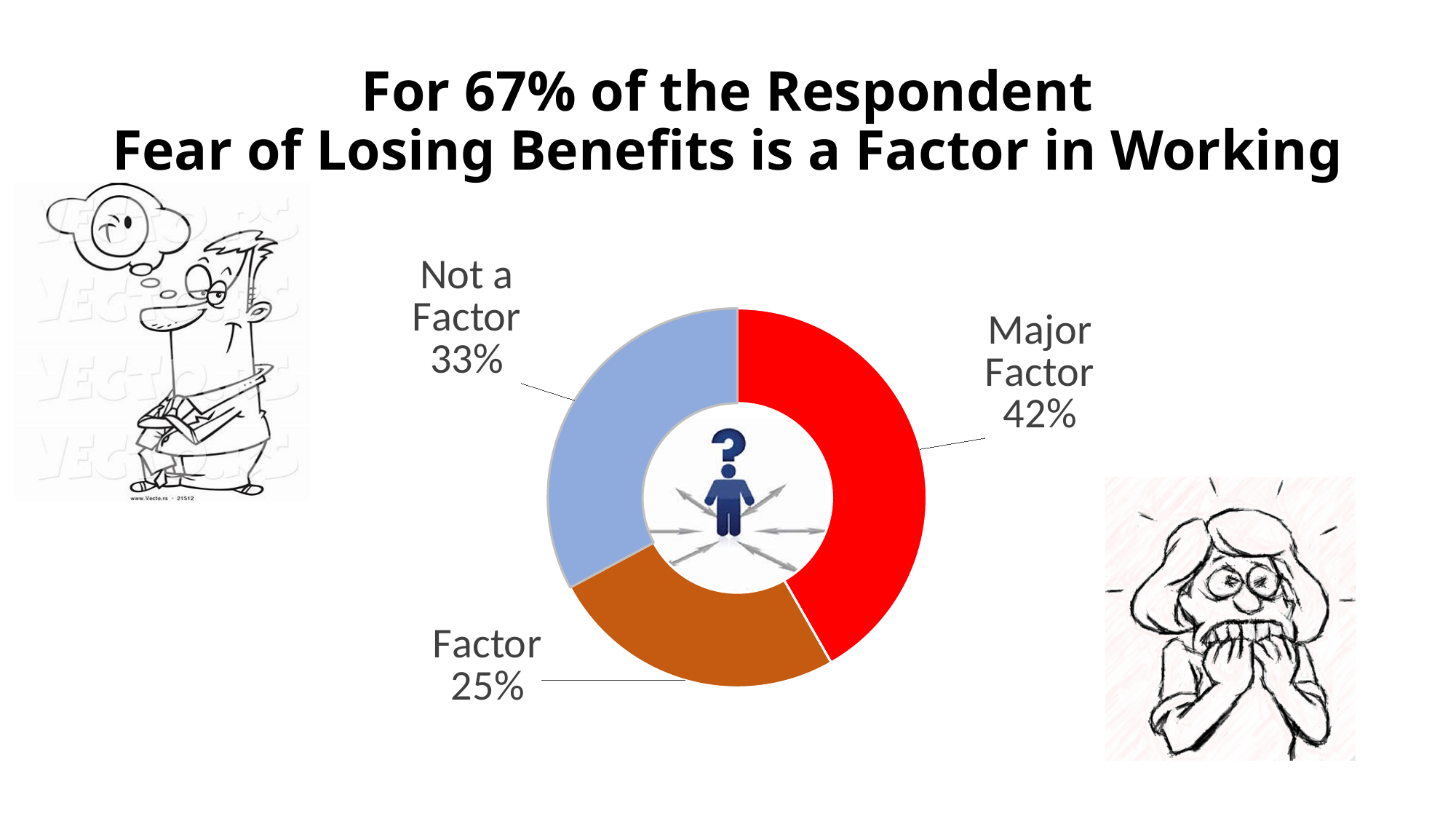
What percentage of respondents said fear of losing benefits is a Major Factor? 42% What kind of chart is shown on the slide? Doughnut (pie) chart How many categories are shown in the chart? 3 Which is larger, the share for Major Factor or the share for Factor? Major Factor What colour is the Major Factor segment of the chart? Red What percentage of respondents said fear of losing benefits is a Factor? 25% Which category has the smallest share of the chart? Factor Which category has the largest share of the chart? Major Factor What is the combined share of Major Factor and Factor? 67% What is the difference in percentage points between Not a Factor and Factor? 8 What is the difference in percentage points between Major Factor and Not a Factor? 9 What percentage of respondents said fear of losing benefits is Not a Factor? 33%